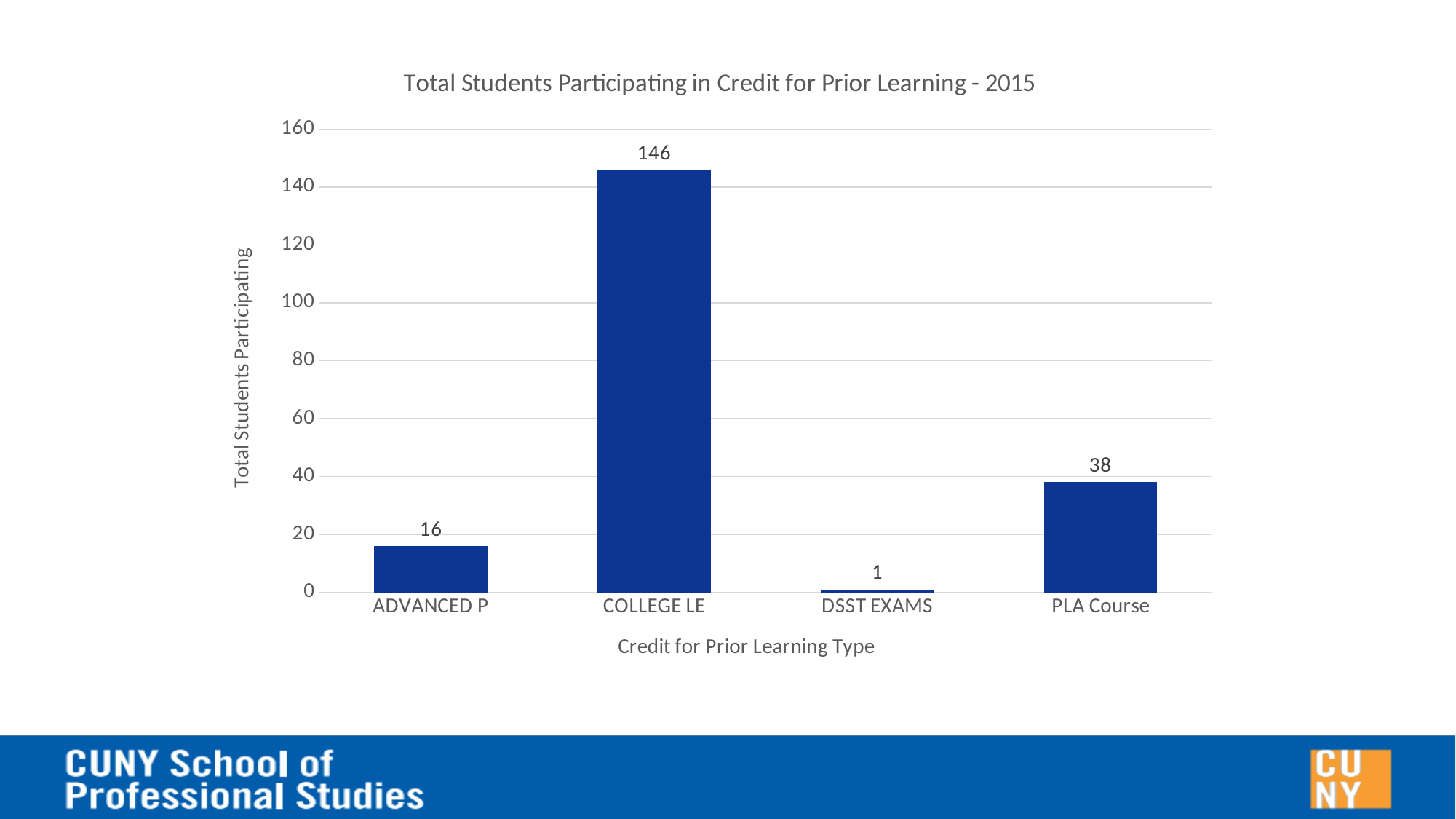
What is the value for DSST EXAMS? 1 What is the value for PLA Course? 38 What is the value for COLLEGE LE? 146 What kind of chart is this? bar chart Which category has the lowest value? DSST EXAMS What is the difference between the values for COLLEGE LE and PLA Course? 108 What is the title of the chart? Total Students Participating in Credit for Prior Learning - 2015 Which category has the highest value? COLLEGE LE How many categories are shown on the x axis? 4 What is the value for ADVANCED P? 16 Which is larger, the value for PLA Course or the value for ADVANCED P? PLA Course Is the value for COLLEGE LE greater or less than 140? greater